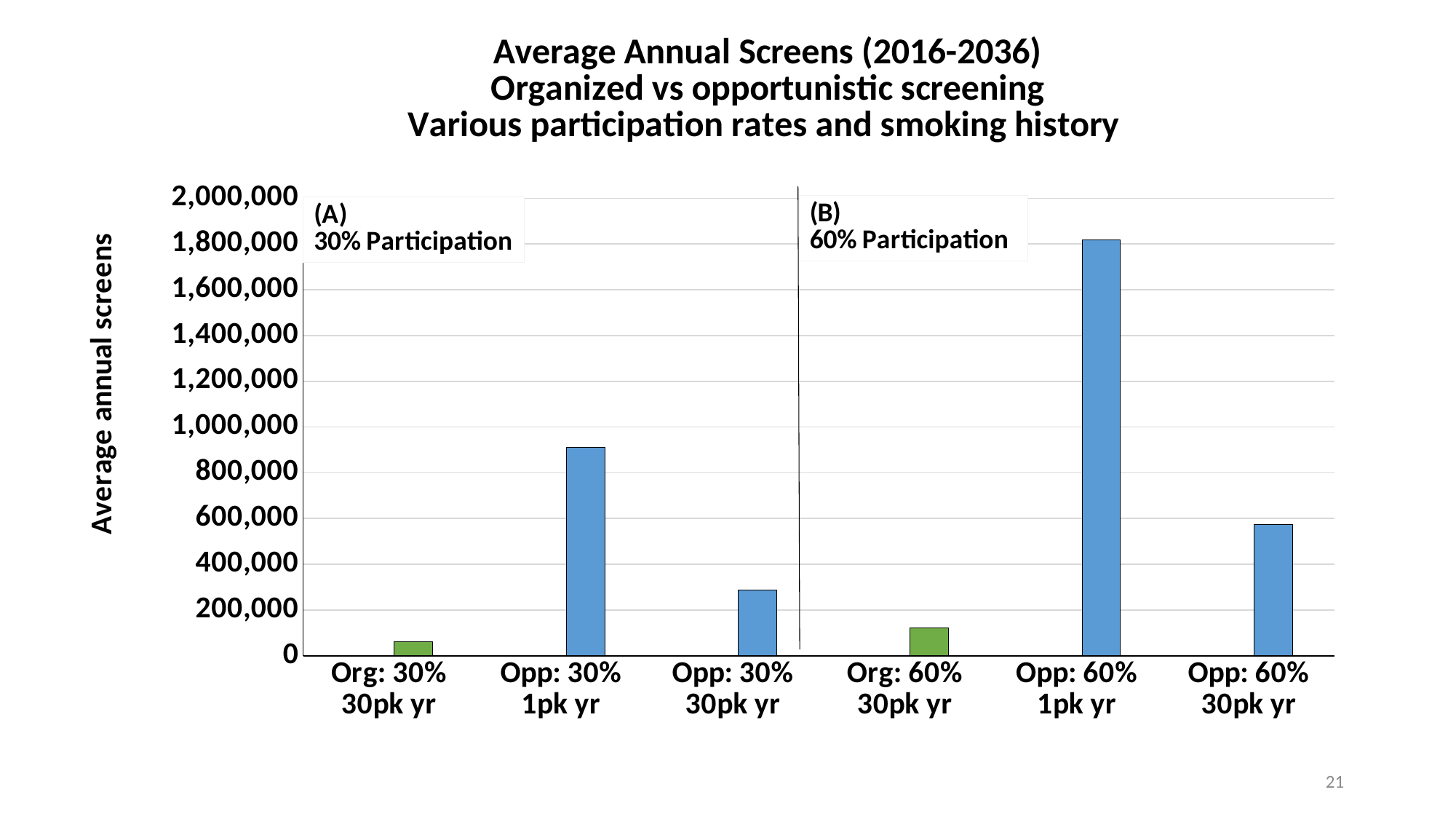
What kind of chart is shown on the slide? bar chart Which is larger, the value for Opp: 30% 30pk yr or the value for Opp: 60% 30pk yr? Opp: 60% 30pk yr What participation rate does panel (B) of the chart represent? 60% Participation How many bars (categories) are plotted on the chart? 6 Which is larger, the value for Org: 30% 30pk yr or the value for Org: 60% 30pk yr? Org: 60% 30pk yr Is the value for Opp: 60% 30pk yr greater or less than 400,000? greater What is the label of the vertical axis? Average annual screens Which category has the highest average annual screens? Opp: 60% 1pk yr Is the value for Opp: 30% 1pk yr greater or less than 1,000,000? less Is the value for Org: 60% 30pk yr greater or less than 200,000? less Which category has the lowest average annual screens? Org: 30% 30pk yr